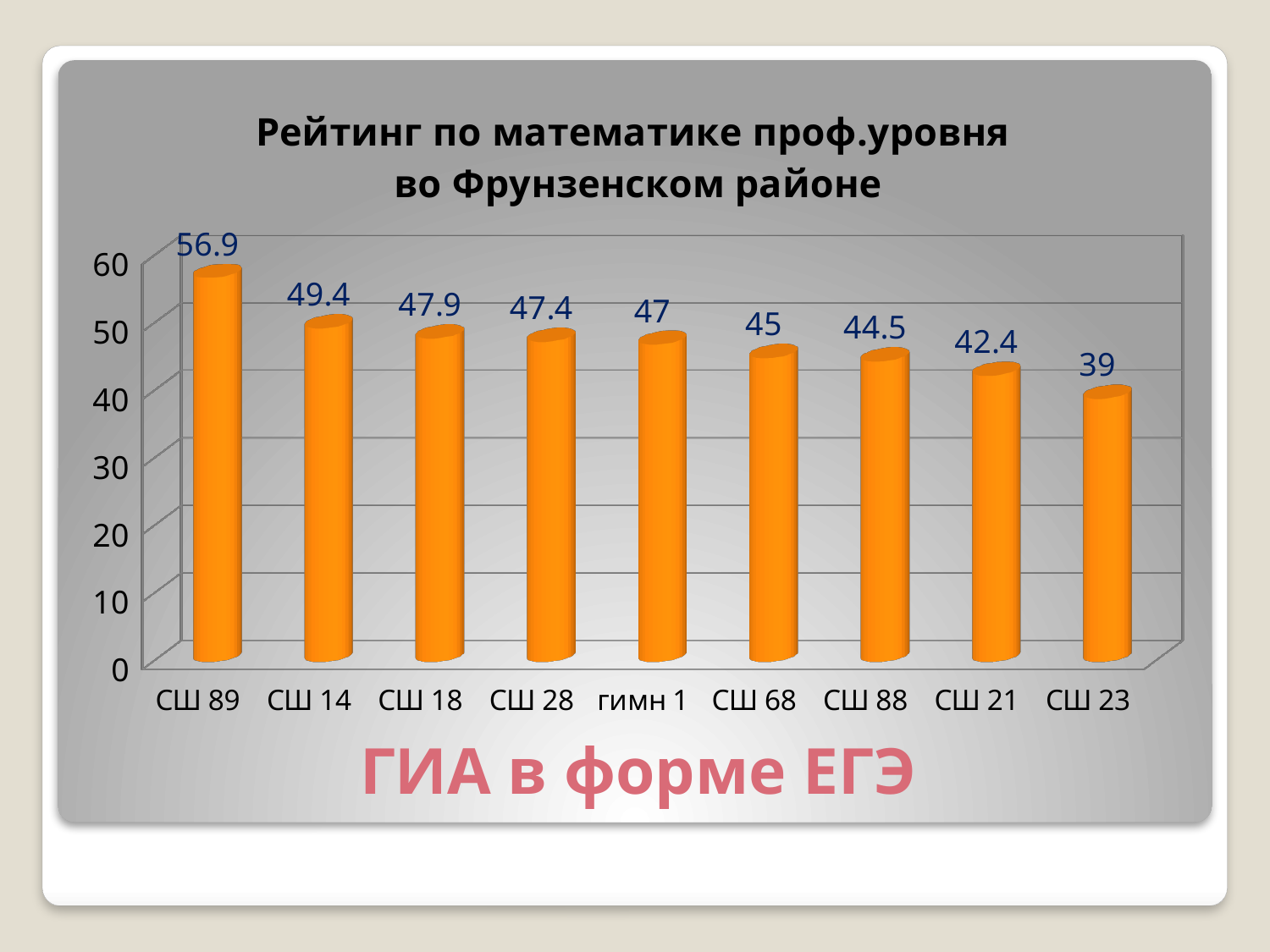
What is the value for СШ 21? 42.4 What is the value for гимн 1? 47 Which is larger, the value for СШ 68 or the value for СШ 88? СШ 68 Which school has the highest value? СШ 89 Is the value for СШ 23 greater or less than 40? less How many schools are shown on the chart? 9 Do the values rise or fall from left to right along the x axis? fall What kind of chart is this? bar chart What is the difference between the values for СШ 14 and СШ 18? 1.5 What is the difference between the values for СШ 89 and СШ 23? 17.9 What is the value for СШ 89? 56.9 Which school has the lowest value? СШ 23